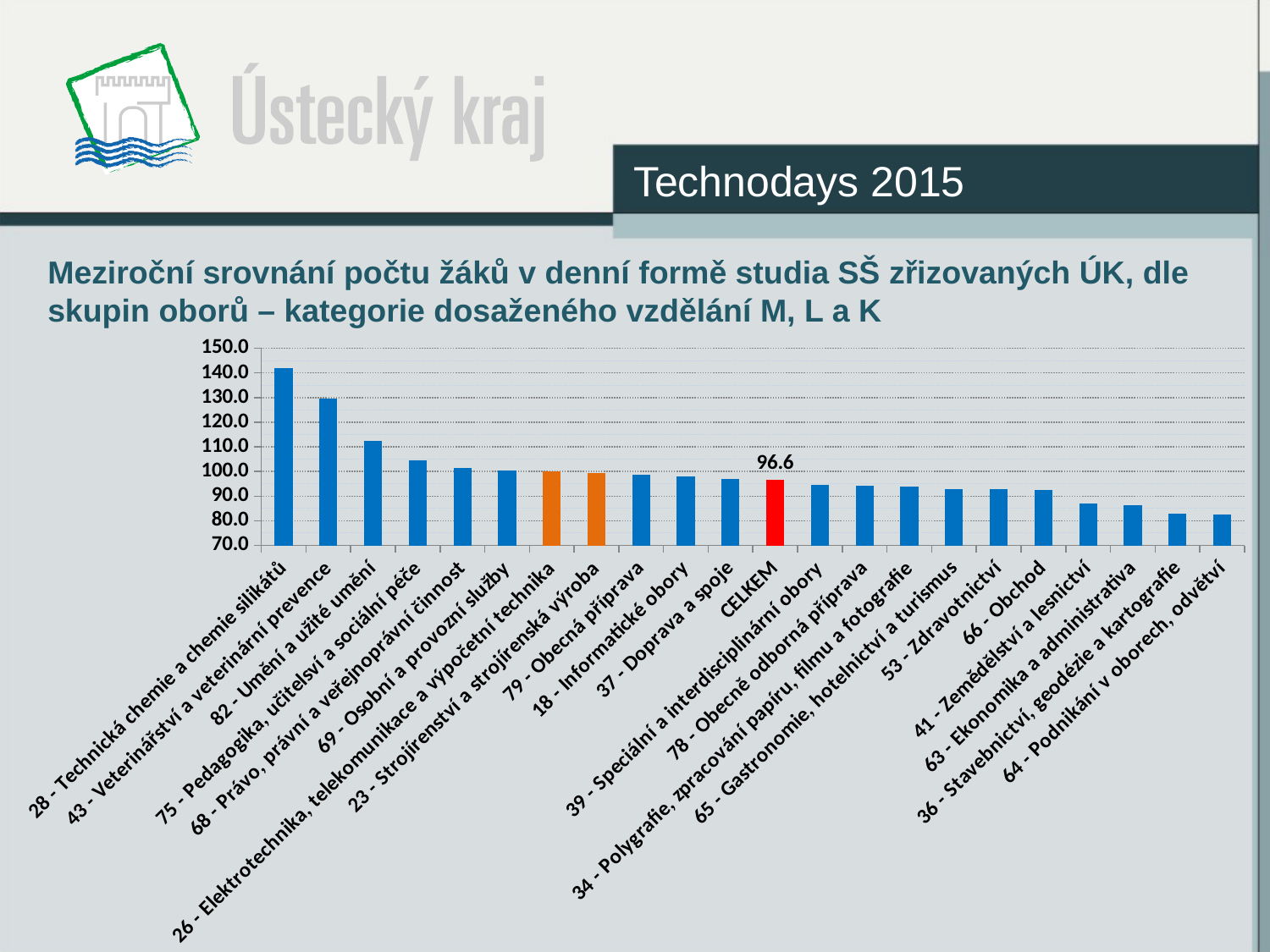
Which category has the highest bar? 28 - Technická chemie a chemie silikátů Which is larger, the value for 43 - Veterinářství a veterinární prevence or for 82 - Umění a užité umění? 43 - Veterinářství a veterinární prevence What colour is the bar for CELKEM? red Do the values rise or fall from left to right along the x axis? fall Is the value for 43 - Veterinářství a veterinární prevence greater or less than 120? greater What value is shown for CELKEM? 96.6 Is the value for 28 - Technická chemie a chemie silikátů greater or less than 130? greater How many bars are plotted in the chart? 22 Which is larger, the value for CELKEM or for 36 - Stavebnictví, geodézie a kartografie? CELKEM Is the value for 64 - Podnikání v oborech, odvětví greater or less than 90? less What kind of chart is shown on the slide? bar chart